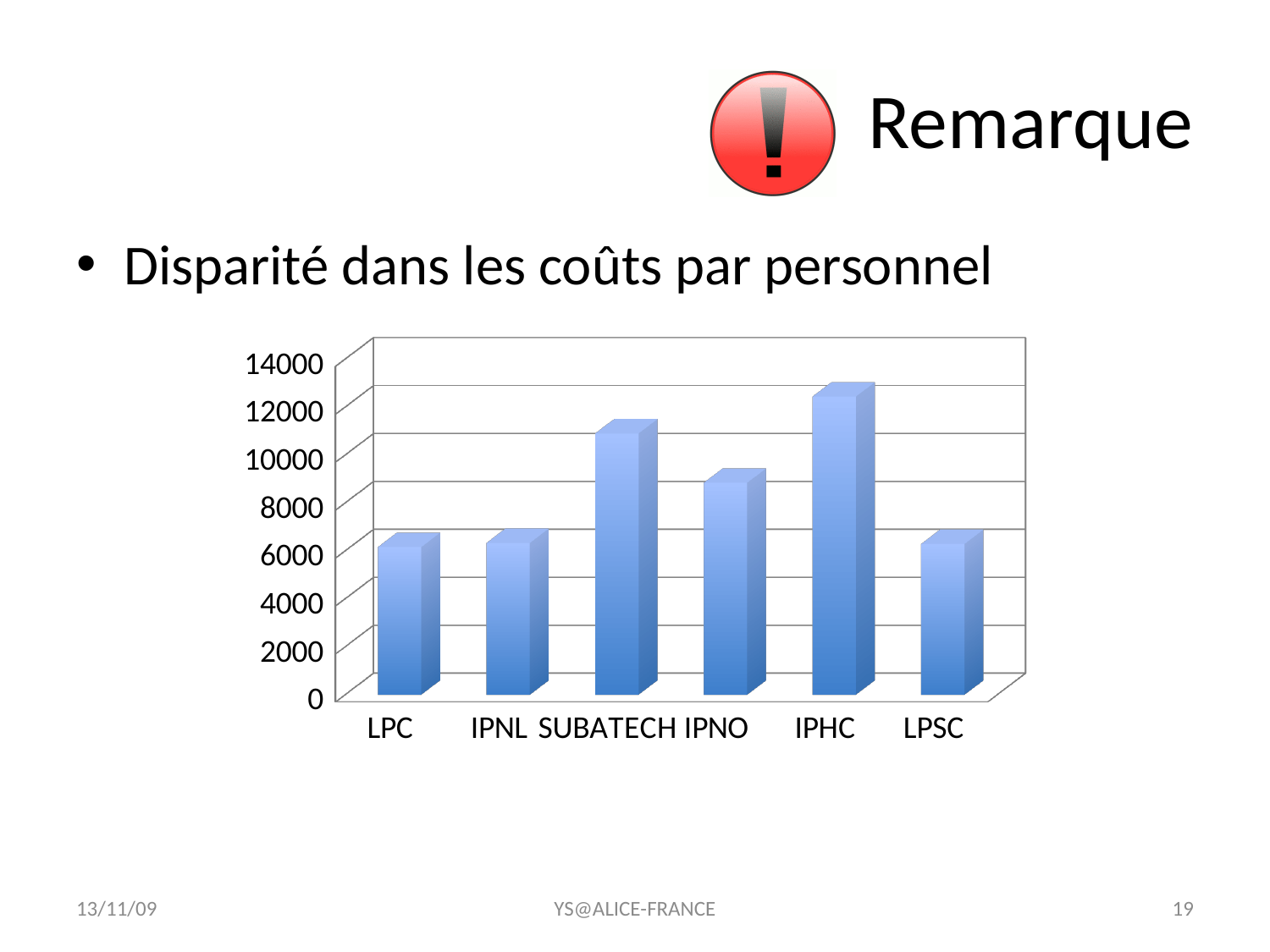
Is the value for SUBATECH greater or less than 8000? greater Which has the larger value, IPNO or LPC? IPNO What is the label of the third category from the left on the x axis? SUBATECH Is the value for IPHC greater or less than 10000? greater What is the highest value labelled on the vertical axis of the chart? 14000 Which has the larger value, IPHC or SUBATECH? IPHC What kind of chart is shown on the slide? bar chart Which has the larger value, SUBATECH or IPNO? SUBATECH How many categories are shown on the x axis of the chart? 6 Which category has the highest bar in the chart? IPHC Is the value for LPSC greater or less than 8000? less